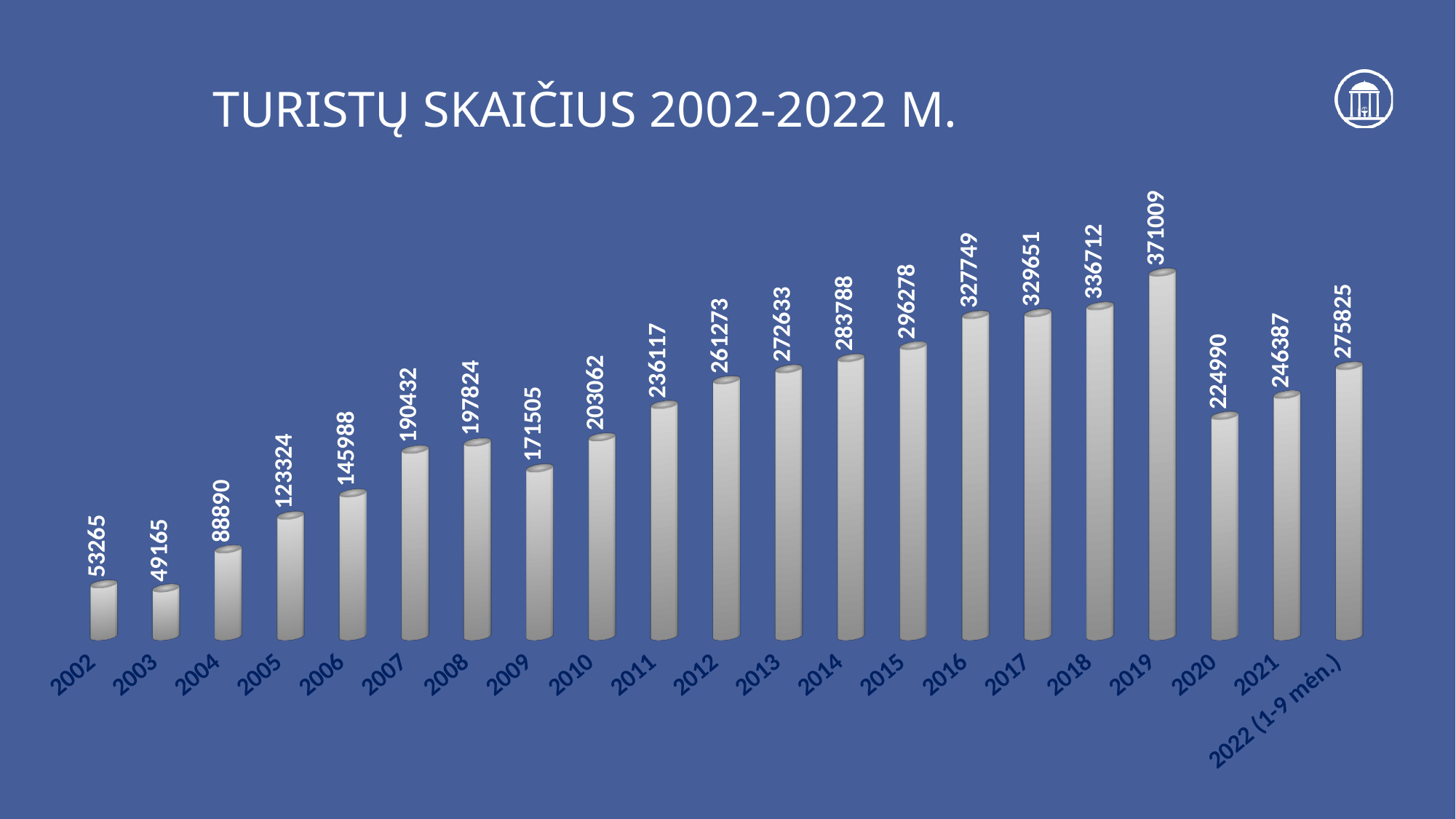
What is the value shown for 2022 (1-9 mėn.)? 275825 Which year has the lowest number of tourists? 2003 What is the difference between the values for 2003 and 2002? 4100 What is the difference between the values for 2019 and 2020? 146019 Which is larger, the value for 2009 or the value for 2008? 2008 What is the title of the chart? TURISTŲ SKAIČIUS 2002-2022 M. What kind of chart is shown on the slide? bar chart How many years (categories) are shown on the chart? 21 Which year has the highest number of tourists? 2019 Which is larger, the value for 2021 or the value for 2020? 2021 What is the number of tourists shown for 2019? 371009 What is the value shown for 2002? 53265